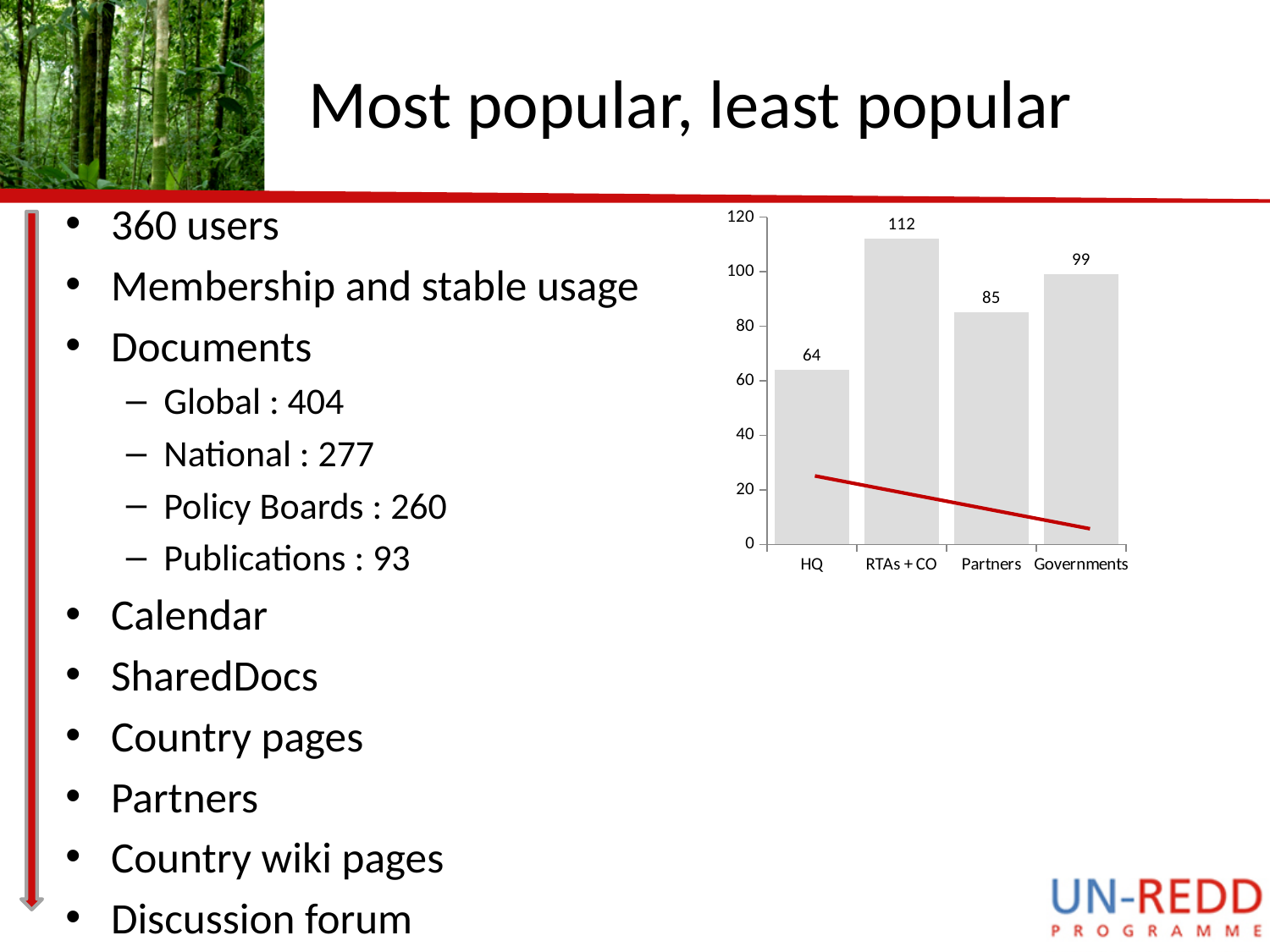
Which category has the lowest value? HQ Which is larger, the value for Partners or the value for Governments? Governments What kind of chart is shown on the slide? bar chart What is the value for Partners? 85 Which category has the highest value? RTAs + CO What is the difference between the values for RTAs + CO and HQ? 48 What is the difference between the values for Governments and Partners? 14 What is the value for Governments? 99 What is the value for HQ? 64 How many categories are shown on the x axis? 4 What is the value for RTAs + CO? 112 Is the value for HQ greater or less than 80? less